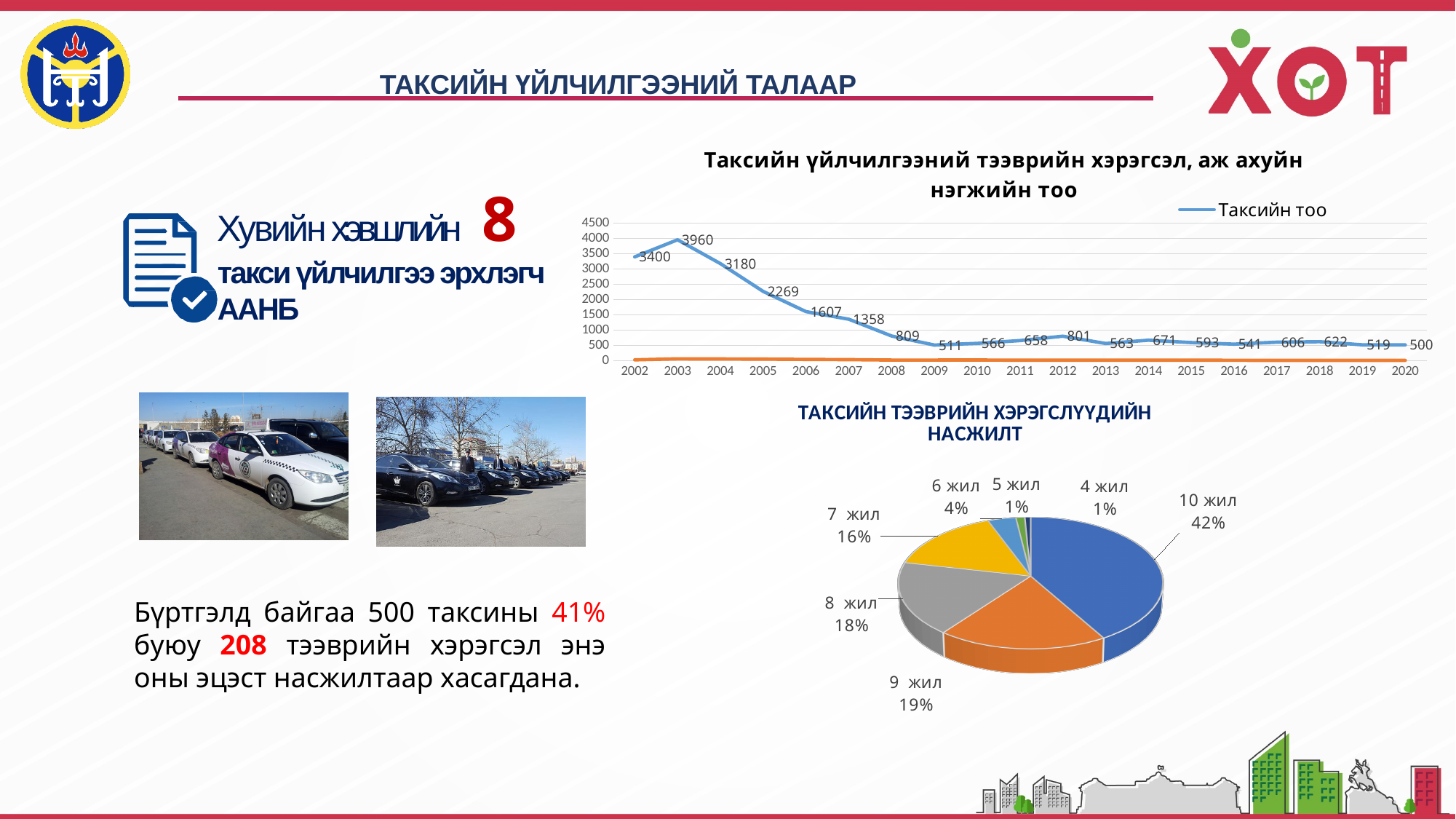
In the line chart 'Таксийн үйлчилгээний тээврийн хэрэгсэл, аж ахуйн нэгжийн тоо', what is the value of Таксийн тоо for 2020? 500 In the pie chart 'ТАКСИЙН ТЭЭВРИЙН ХЭРЭГСЛҮҮДИЙН НАСЖИЛТ', how many slices are there? 7 What kind of chart is 'ТАКСИЙН ТЭЭВРИЙН ХЭРЭГСЛҮҮДИЙН НАСЖИЛТ'? pie chart In the line chart 'Таксийн үйлчилгээний тээврийн хэрэгсэл, аж ахуйн нэгжийн тоо', which year has a larger Таксийн тоо value, 2012 or 2014? 2012 In the line chart 'Таксийн үйлчилгээний тээврийн хэрэгсэл, аж ахуйн нэгжийн тоо', what is the difference between the Таксийн тоо values for 2002 and 2009? 2889 In the line chart 'Таксийн үйлчилгээний тээврийн хэрэгсэл, аж ахуйн нэгжийн тоо', which year has the highest value of Таксийн тоо? 2003 In the line chart 'Таксийн үйлчилгээний тээврийн хэрэгсэл, аж ахуйн нэгжийн тоо', what is the value of Таксийн тоо for 2003? 3960 In the pie chart 'ТАКСИЙН ТЭЭВРИЙН ХЭРЭГСЛҮҮДИЙН НАСЖИЛТ', which category has the largest share? 10 жил In the pie chart 'ТАКСИЙН ТЭЭВРИЙН ХЭРЭГСЛҮҮДИЙН НАСЖИЛТ', what share does the 10 жил slice have? 42% In the line chart 'Таксийн үйлчилгээний тээврийн хэрэгсэл, аж ахуйн нэгжийн тоо', does the Таксийн тоо value rise or fall from 2003 to 2009? fall In the line chart 'Таксийн үйлчилгээний тээврийн хэрэгсэл, аж ахуйн нэгжийн тоо', how many years are shown on the x axis? 19 In the line chart 'Таксийн үйлчилгээний тээврийн хэрэгсэл, аж ахуйн нэгжийн тоо', which year has the lowest value of Таксийн тоо? 2020